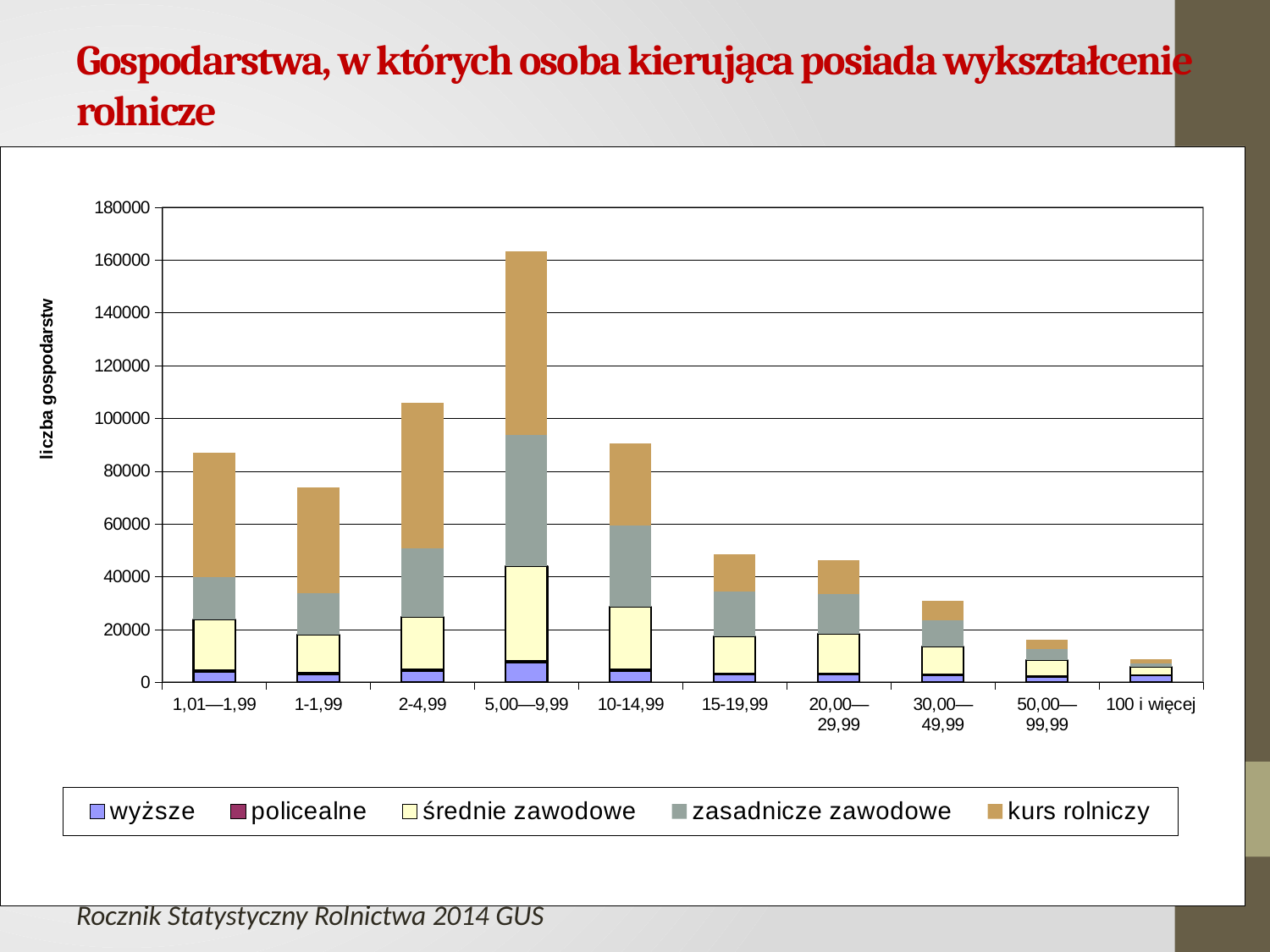
Is the total value for 50,00—99,99 greater or less than 20000? less Is the total value for 5,00—9,99 greater or less than 140000? greater Which has the larger total bar: 2-4,99 or 10-14,99? 2-4,99 What is the label of the y axis? liczba gospodarstw Which has the larger total bar: 1,01—1,99 or 1-1,99? 1,01—1,99 What kind of chart is shown on the slide? stacked bar chart Which category has the shortest stacked bar? 100 i więcej How many categories are shown on the x axis of the chart? 10 How many series does the legend list? 5 Which category has the tallest stacked bar? 5,00—9,99 From 5,00—9,99 to 100 i więcej, do the total bar heights rise or fall along the x axis? fall Is the total value for 1,01—1,99 greater or less than 80000? greater